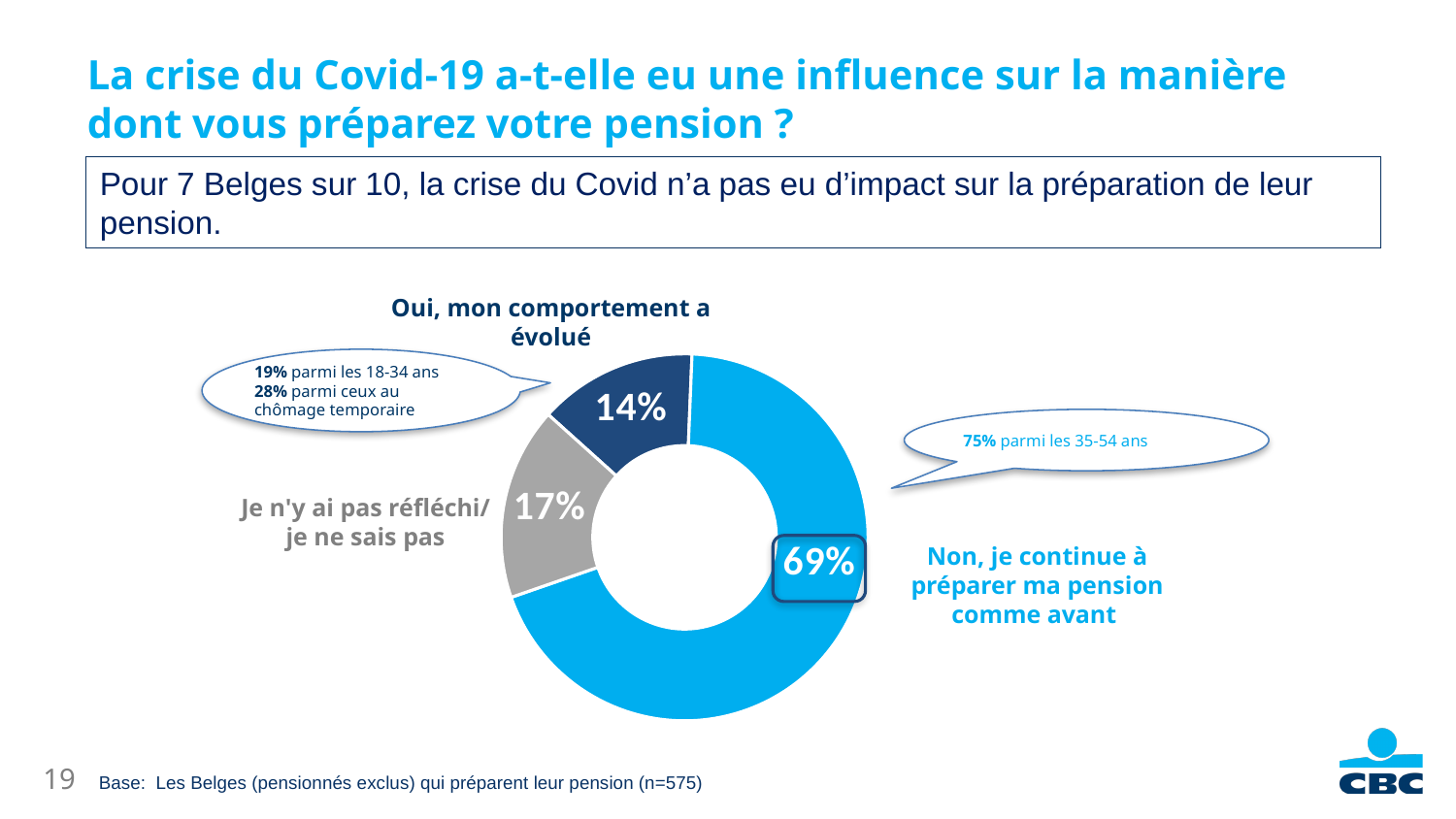
What share of respondents answered "Je n'y ai pas réfléchi/ je ne sais pas"? 17% Which is larger: the share for "Oui, mon comportement a évolué" or the share for "Je n'y ai pas réfléchi/ je ne sais pas"? Je n'y ai pas réfléchi/ je ne sais pas Which response has the smallest share of the pie? Oui, mon comportement a évolué What kind of chart is shown on the slide? Pie chart (doughnut) According to the callout, what share of 35-54 year olds continue to prepare their pension as before? 75% What share of respondents answered "Oui, mon comportement a évolué"? 14% What is the difference in percentage points between "Je n'y ai pas réfléchi/ je ne sais pas" and "Oui, mon comportement a évolué"? 3 percentage points How many slices does the pie chart have? 3 What share of respondents answered "Non, je continue à préparer ma pension comme avant"? 69% According to the callout, what share of those on temporary unemployment said their behaviour changed? 28% What is the difference in percentage points between "Non, je continue à préparer ma pension comme avant" and "Je n'y ai pas réfléchi/ je ne sais pas"? 52 percentage points Which response has the largest share of the pie? Non, je continue à préparer ma pension comme avant